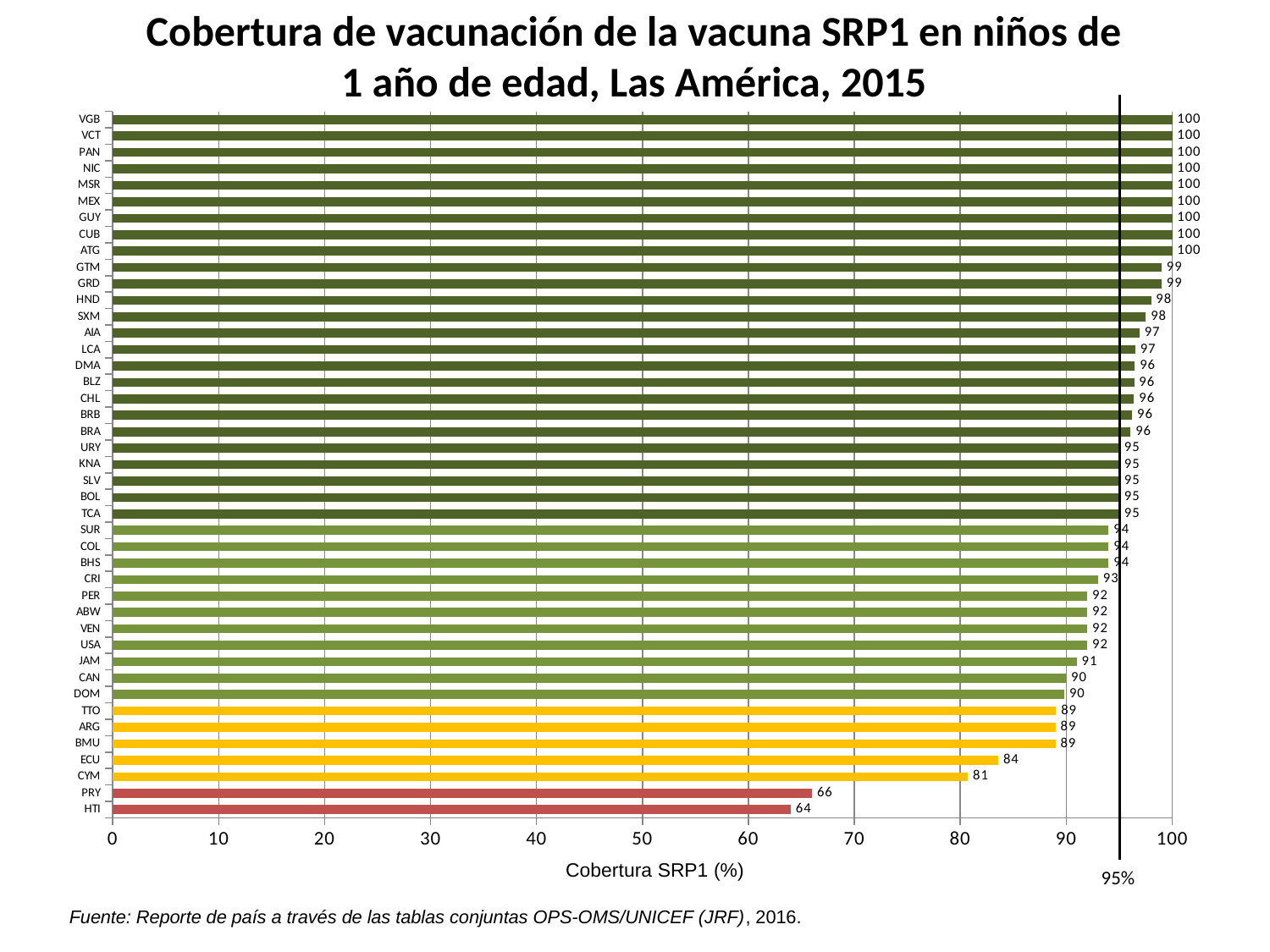
What value does the vertical reference line in the chart mark? 95% What is the difference between the coverage values for VGB and CYM? 19 What is the difference between the coverage values for PRY and HTI? 2 How many countries are shown in the chart? 43 What is the SRP1 coverage value for CYM? 81 What is the SRP1 coverage value for HTI? 64 Which country has the lowest SRP1 coverage? HTI Which has a higher coverage value, ECU or CYM? ECU What kind of chart is shown on the slide? Bar chart Which has a higher coverage value, CRI or JAM? CRI What is the SRP1 coverage value for HND? 98 What is the SRP1 coverage value for ECU? 84